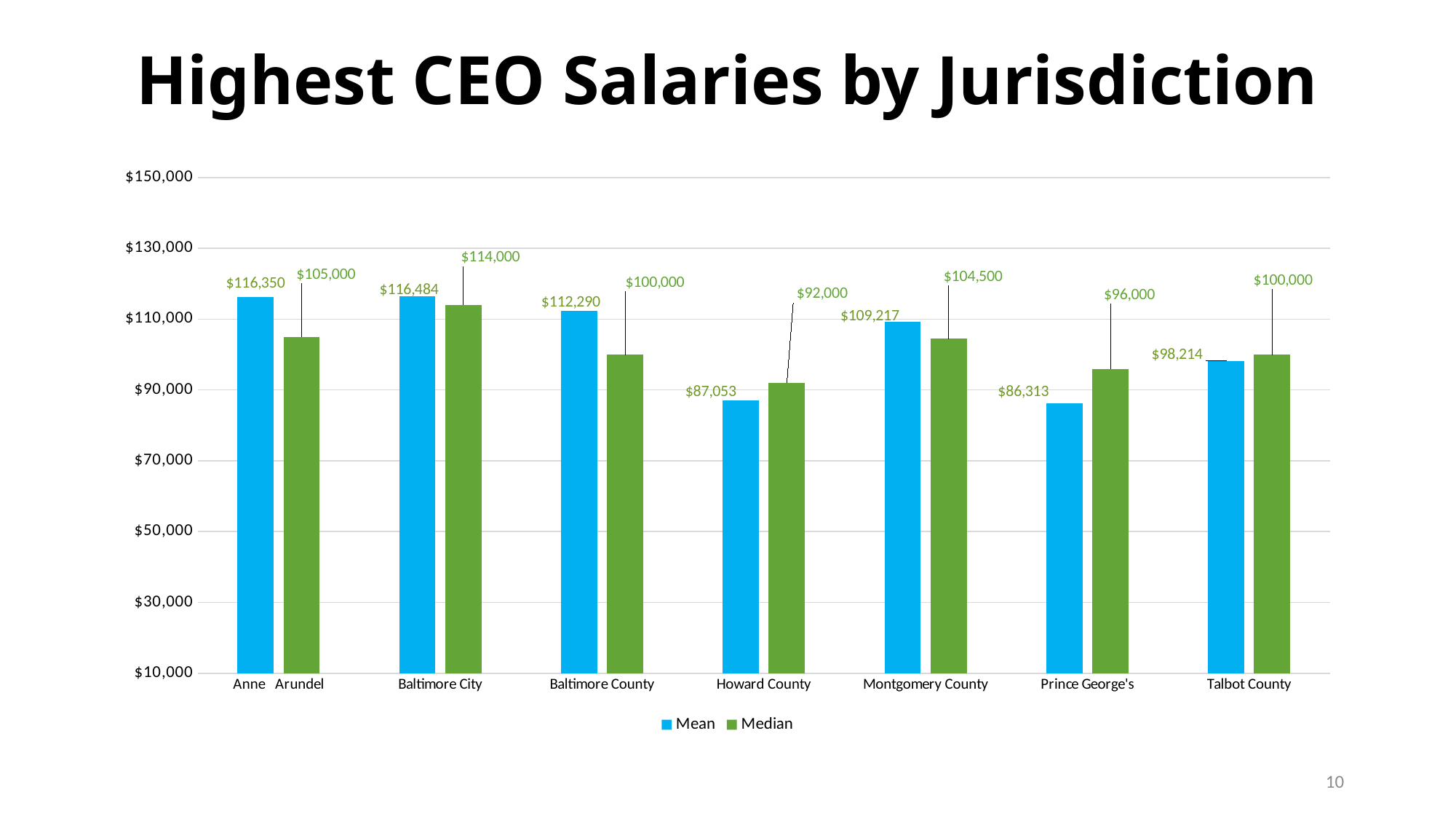
What is the difference between the Median and Mean values for Howard County? $4,947 What is the difference between the Mean and Median values for Anne Arundel? $11,350 How many jurisdictions are shown on the x axis? 7 Is the Mean value for Prince George's greater or less than $90,000? less Which jurisdiction has the lowest Median value? Howard County What is the Mean value for Montgomery County? $109,217 Which jurisdiction has the highest Median value? Baltimore City What kind of chart is shown on the slide? bar chart What is the Mean value for Anne Arundel? $116,350 How many series does the legend list? 2 What is the Median value for Prince George's? $96,000 For Talbot County, which is larger, the Mean or the Median? Median